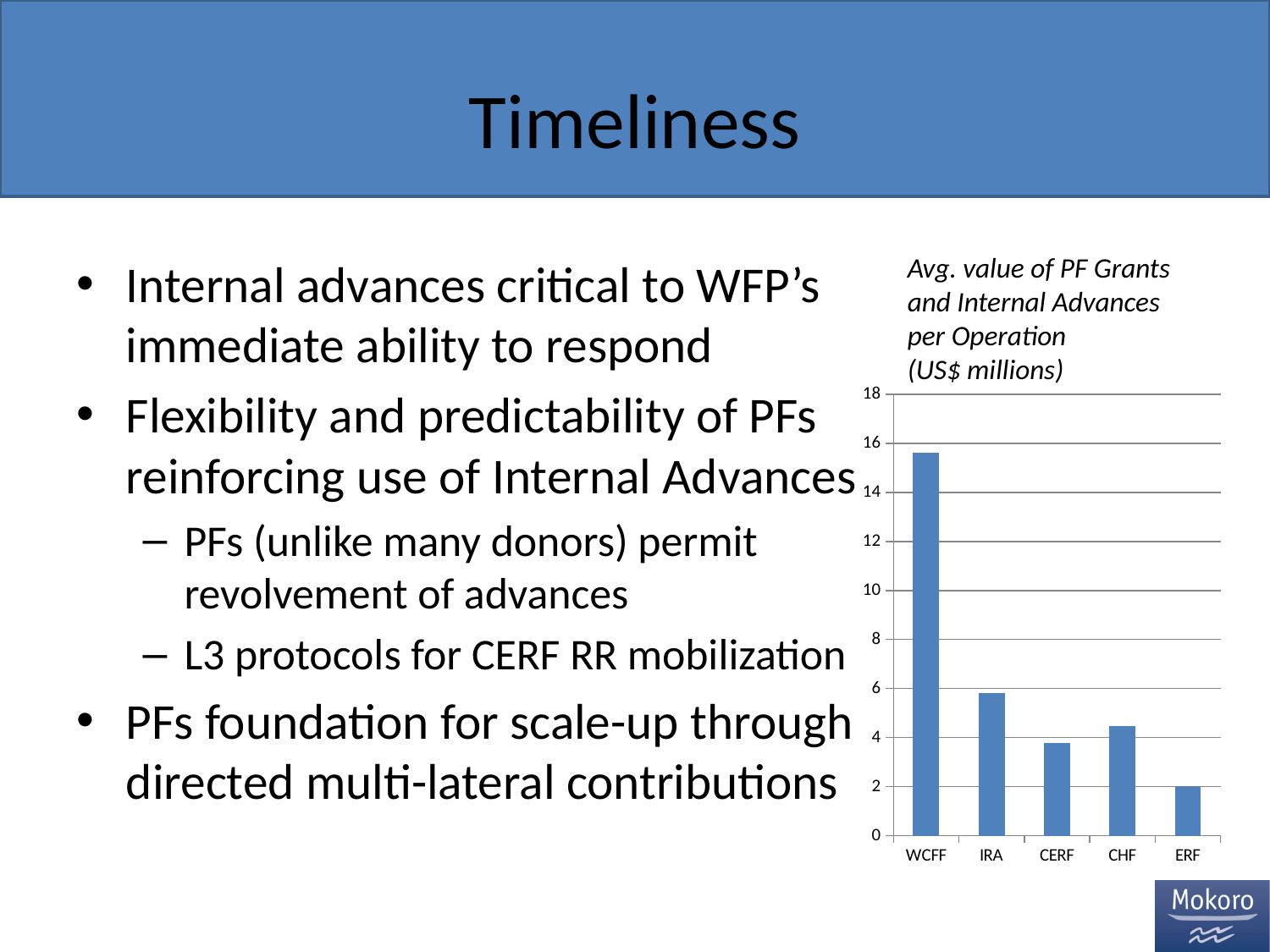
Is the value for ERF greater or less than 4? less Which has a larger value, IRA or CHF? IRA How many categories are shown on the x axis of the chart? 5 Which category has the highest value in the chart? WCFF Is the value for IRA greater or less than 4? greater Which has a larger value, WCFF or IRA? WCFF What is the title of the chart? Avg. value of PF Grants and Internal Advances per Operation (US$ millions) Is the value for WCFF greater or less than 14? greater What kind of chart is shown on the slide? bar chart Which category has the lowest value in the chart? ERF